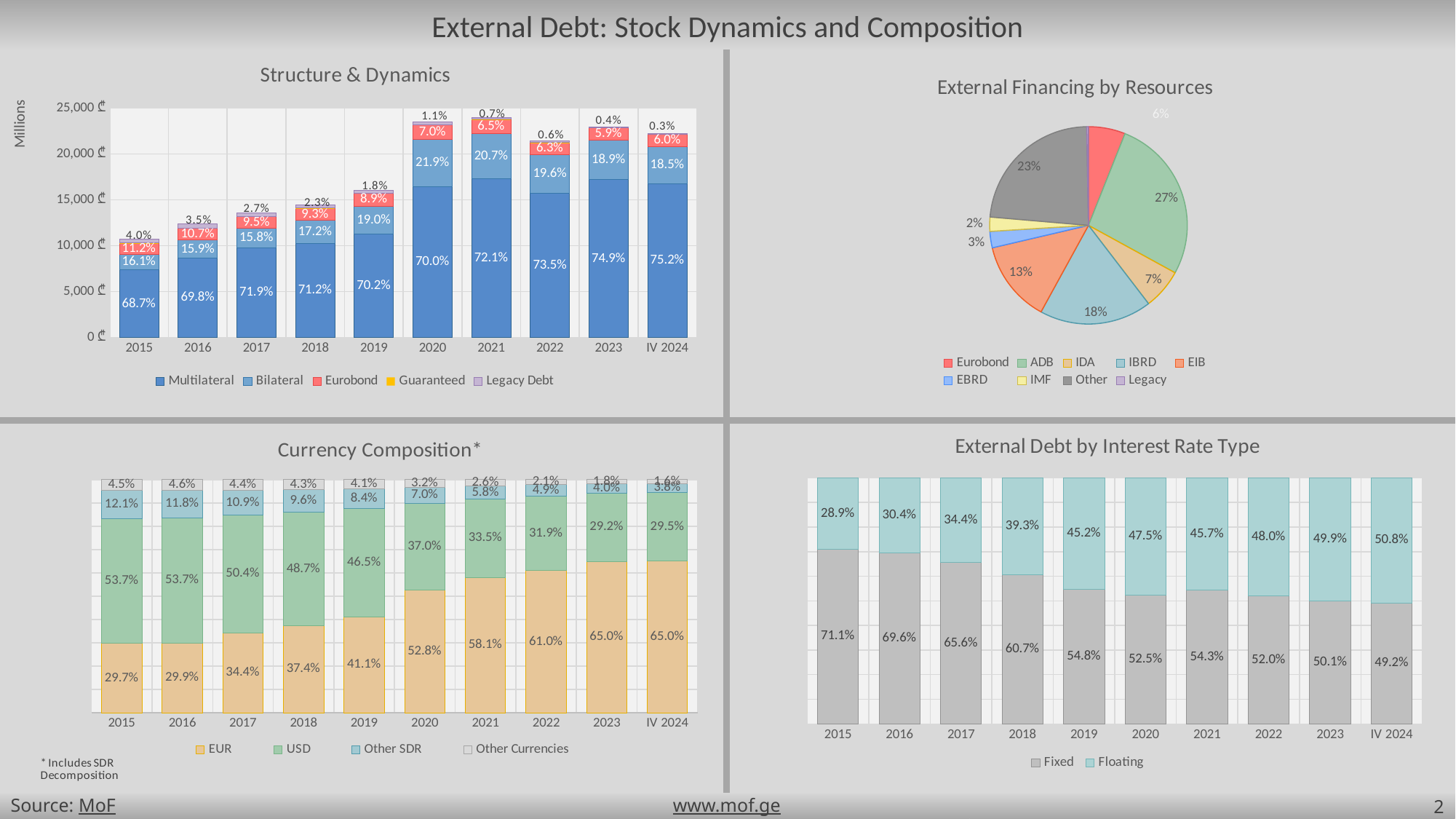
In the External Financing by Resources pie chart, what is the difference between the IBRD and EIB shares? 5% In the Currency Composition chart, what is the EUR share for 2019? 41.1% In the Structure & Dynamics chart, how many series does the legend list? 5 In the External Debt by Interest Rate Type chart, in which year is the Fixed share highest? 2015 In the Structure & Dynamics chart, what is the Eurobond share for 2015? 11.2% What kind of chart is External Debt by Interest Rate Type? stacked bar chart In the Currency Composition chart, does the EUR share rise or fall from 2015 to IV 2024? rise In the Currency Composition chart, which is larger in 2016: the USD share or the EUR share? USD In the External Financing by Resources pie chart, which labelled slice is the largest? ADB In the External Debt by Interest Rate Type chart, what is the Floating share for 2018? 39.3% In the Structure & Dynamics chart, what is the Multilateral share for 2021? 72.1% In the External Financing by Resources pie chart, what share does ADB have? 27%